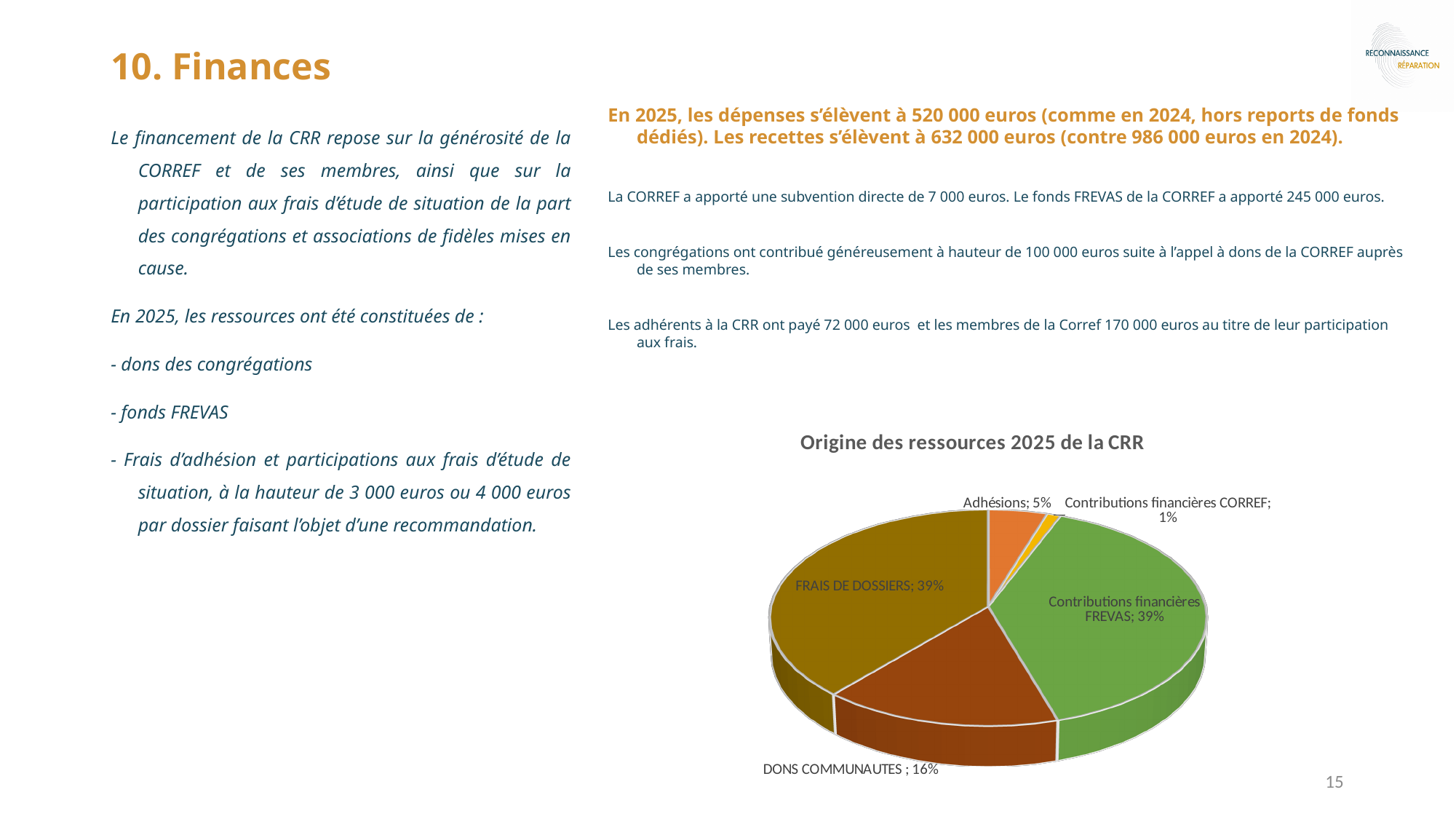
What share of the pie does "Contributions financières CORREF" represent? 1% Which slice of the pie chart is the smallest? Contributions financières CORREF What is the title of the pie chart? Origine des ressources 2025 de la CRR Which is larger: the share for "Adhésions" or the share for "Contributions financières CORREF"? Adhésions What share of the pie does "DONS COMMUNAUTES" represent? 16% What share of the pie does "Contributions financières FREVAS" represent? 39% What kind of chart is shown under the title "Origine des ressources 2025 de la CRR"? pie chart How many slices does the pie chart have? 5 Which is larger: the share for "Contributions financières FREVAS" or the share for "DONS COMMUNAUTES"? Contributions financières FREVAS By how many percentage points does the "FRAIS DE DOSSIERS" share exceed the "DONS COMMUNAUTES" share? 23 percentage points